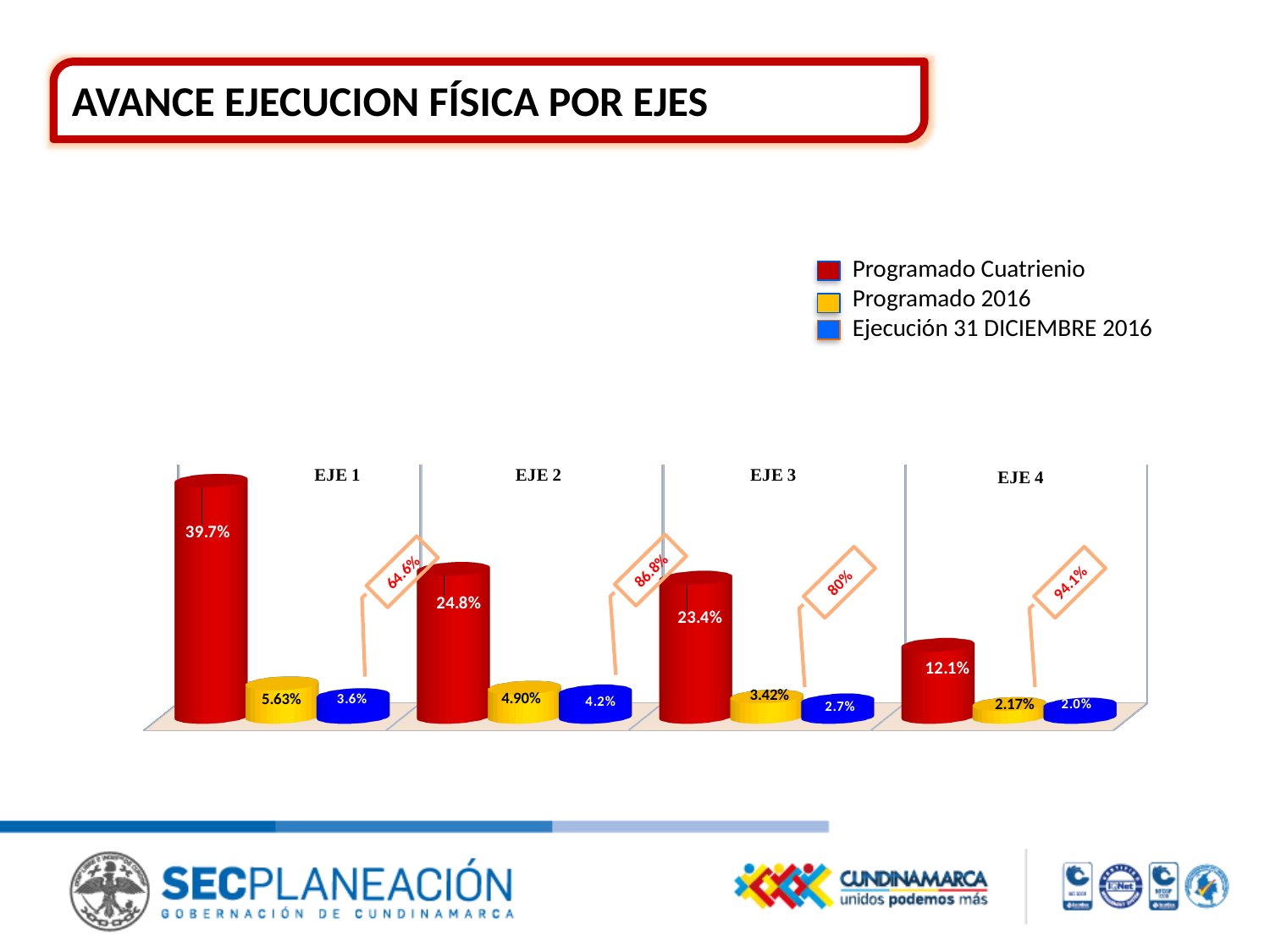
What is the difference between the Programado Cuatrienio values for EJE 1 and EJE 2? 14.9% Which is larger, the Ejecución 31 DICIEMBRE 2016 value for EJE 1 or for EJE 2? EJE 2 How many series does the legend list? 3 What kind of chart is shown on the slide? Bar chart What is the Programado 2016 value for EJE 2? 4.90% Which EJE has the highest Programado Cuatrienio value? EJE 1 What percentage is shown in the callout label for EJE 4? 94.1% What is the Programado Cuatrienio value for EJE 1? 39.7% Which EJE has the lowest Ejecución 31 DICIEMBRE 2016 value? EJE 4 How many EJE categories are shown on the chart? 4 What is the Programado Cuatrienio value for EJE 4? 12.1% What is the Ejecución 31 DICIEMBRE 2016 value for EJE 3? 2.7%